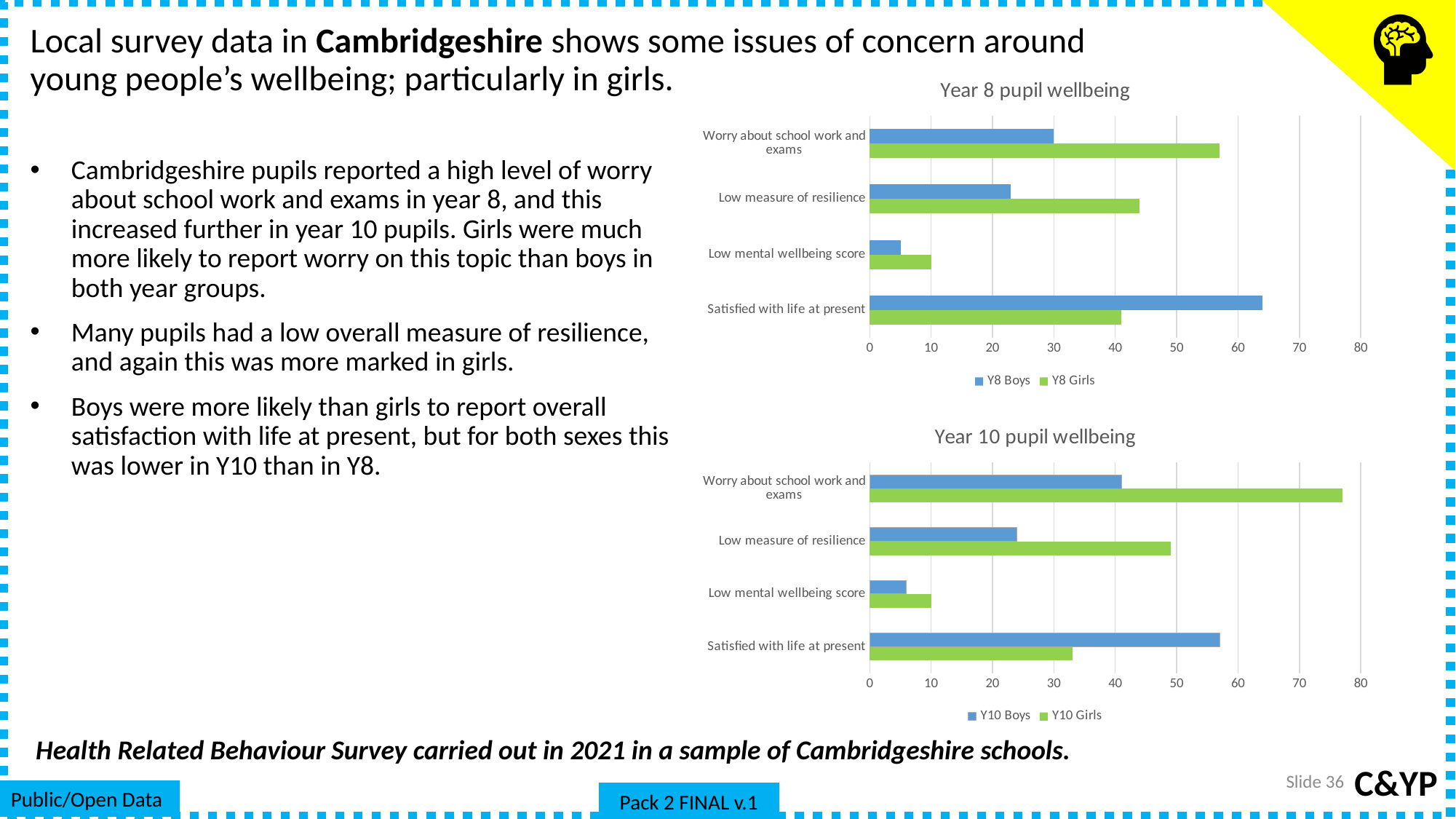
In the "Year 8 pupil wellbeing" chart, is the Y8 Girls value for "Worry about school work and exams" greater or less than 50? greater In the "Year 8 pupil wellbeing" chart, which colour represents Y8 Girls? green How many categories are shown on the "Year 8 pupil wellbeing" chart? 4 What kind of chart is the "Year 8 pupil wellbeing" chart? bar chart In the "Year 10 pupil wellbeing" chart, is the Y10 Girls value for "Worry about school work and exams" greater or less than 70? greater In the "Year 10 pupil wellbeing" chart, which category has the lowest Y10 Girls value? Low mental wellbeing score In the "Year 10 pupil wellbeing" chart, which is larger for "Satisfied with life at present": Y10 Boys or Y10 Girls? Y10 Boys In the "Year 10 pupil wellbeing" chart, is the Y10 Boys value for "Low mental wellbeing score" greater or less than 10? less How many series does the legend of the "Year 10 pupil wellbeing" chart list? 2 In the "Year 8 pupil wellbeing" chart, which category has the highest Y8 Boys value? Satisfied with life at present In the "Year 8 pupil wellbeing" chart, which category has the highest Y8 Girls value? Worry about school work and exams